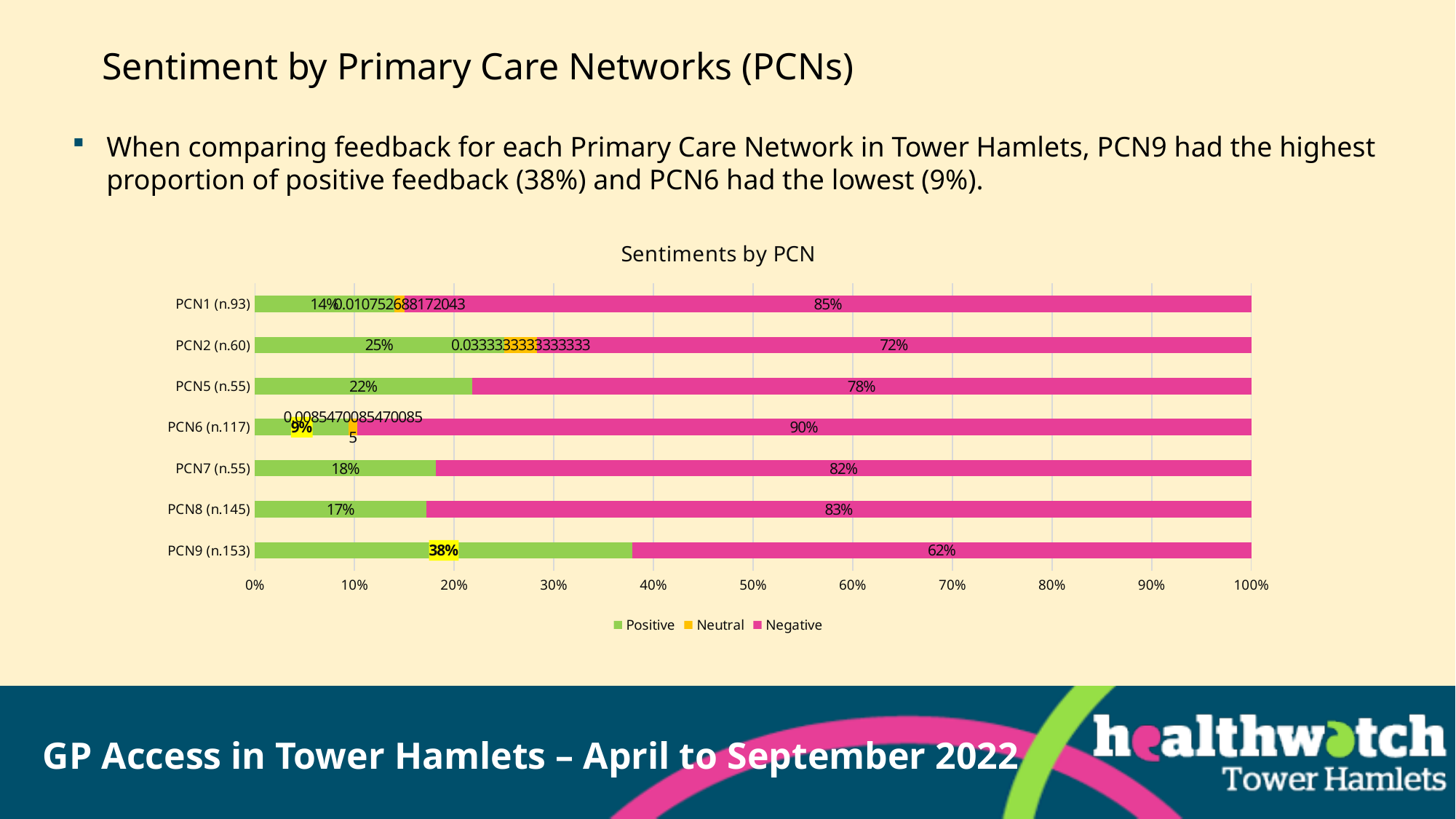
What is the Positive value for PCN9 (n.153)? 38% Which PCN has the lowest Negative value? PCN9 (n.153) How many PCN categories are plotted in the Sentiments by PCN chart? 7 Which is larger, the Positive value for PCN5 (n.55) or the Positive value for PCN7 (n.55)? PCN5 (n.55) Which PCN has the highest Positive value? PCN9 (n.153) What is the Negative value for PCN6 (n.117)? 90% How many series does the legend of the Sentiments by PCN chart list? 3 What is the difference between the Negative values for PCN6 (n.117) and PCN9 (n.153)? 28% Is the Negative value for PCN2 (n.60) greater or less than 80%? less What is the Positive value for PCN2 (n.60)? 25% What is the title of the chart? Sentiments by PCN What type of chart is shown on the slide? Stacked bar chart